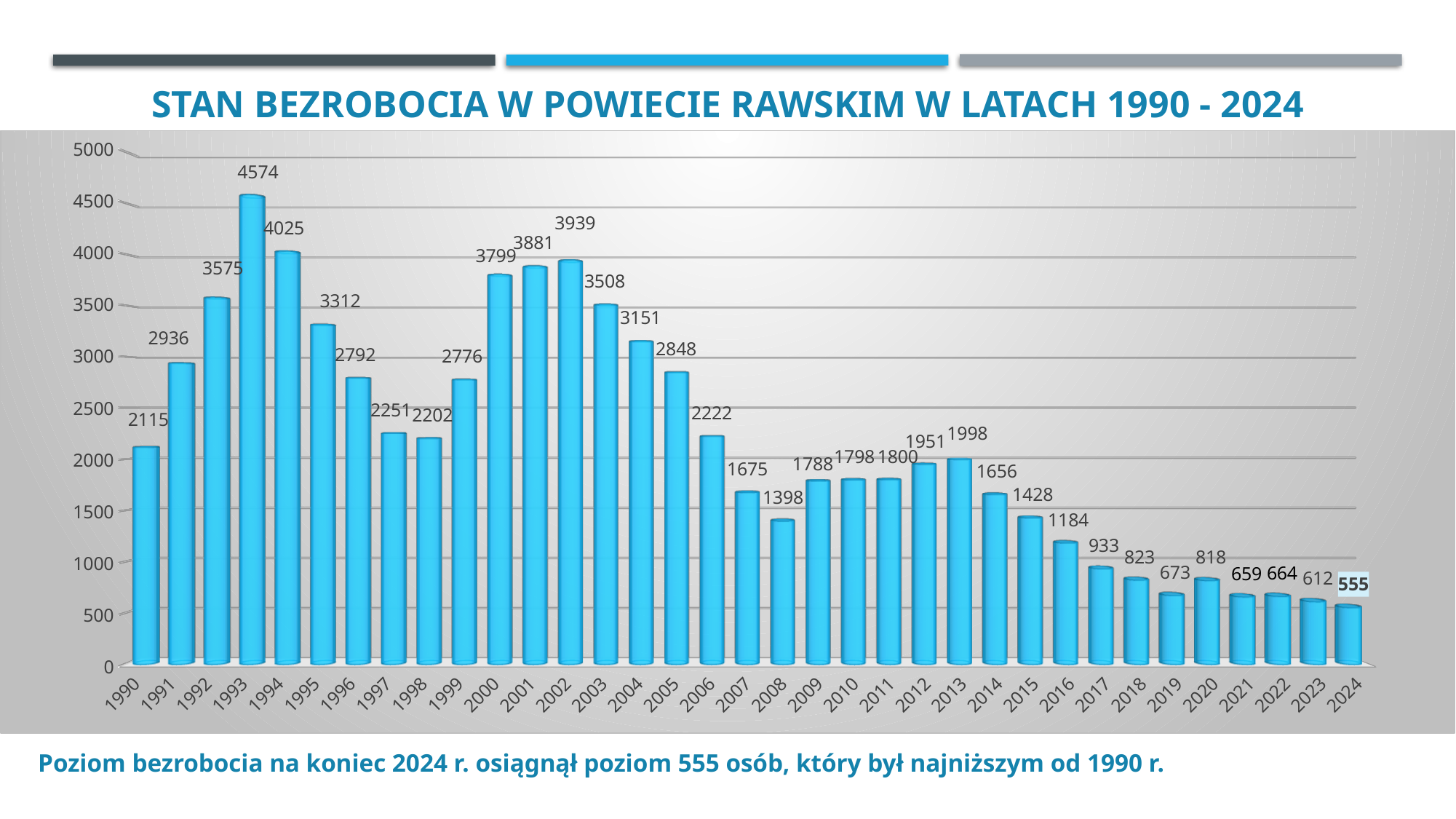
What is the title of the chart? STAN BEZROBOCIA W POWIECIE RAWSKIM W LATACH 1990 - 2024 How many years are shown on the x axis? 35 Which year has the highest value? 1993 What is the value for 2024? 555 Which year has the lowest value? 2024 Is the value for 2016 greater or less than 1000? greater What is the value for 1993? 4574 What is the value for 2008? 1398 What is the difference between the values for 2002 and 2003? 431 Which is larger, the value for 2000 or the value for 2005? 2000 What type of chart is shown on the slide? bar chart What is the difference between the values for 1993 and 1994? 549